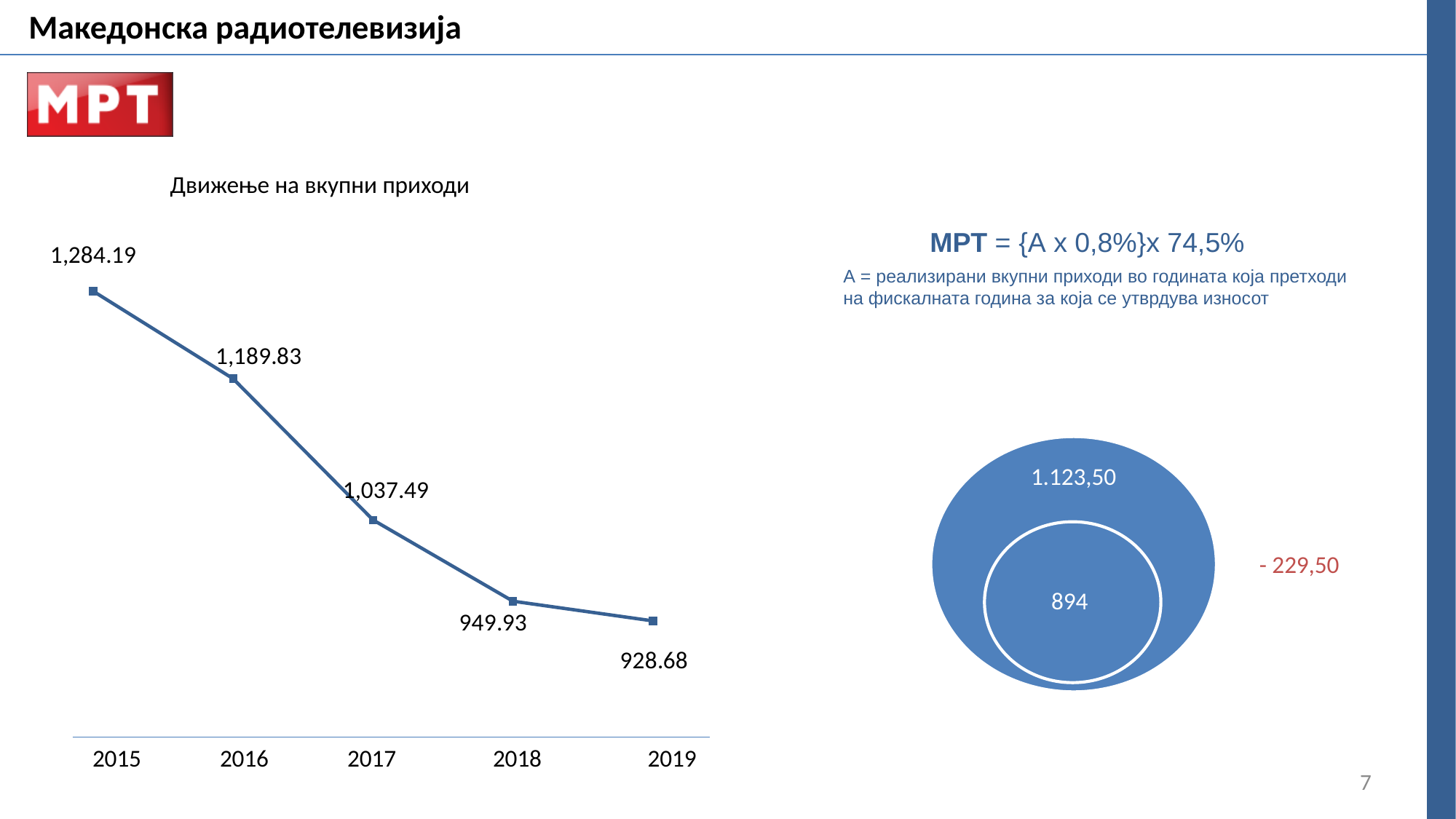
What is the difference between the values for 2015 and 2016 in the line chart? 94.36 Which year has the highest value in the line chart? 2015 What is the value for 2016 in the line chart? 1,189.83 What is the value for 2017 in the line chart? 1,037.49 What is the value for 2018 in the line chart? 949.93 What is the value for 2019 in the line chart? 928.68 What type of chart is shown under the title "Движење на вкупни приходи"? line chart Which year has the lowest value in the line chart? 2019 How many years are plotted on the x axis of the line chart? 5 What is the value for 2015 in the line chart? 1,284.19 What is the difference between the values for 2018 and 2019 in the line chart? 21.25 Do the values in the line chart rise or fall from 2015 to 2019? fall